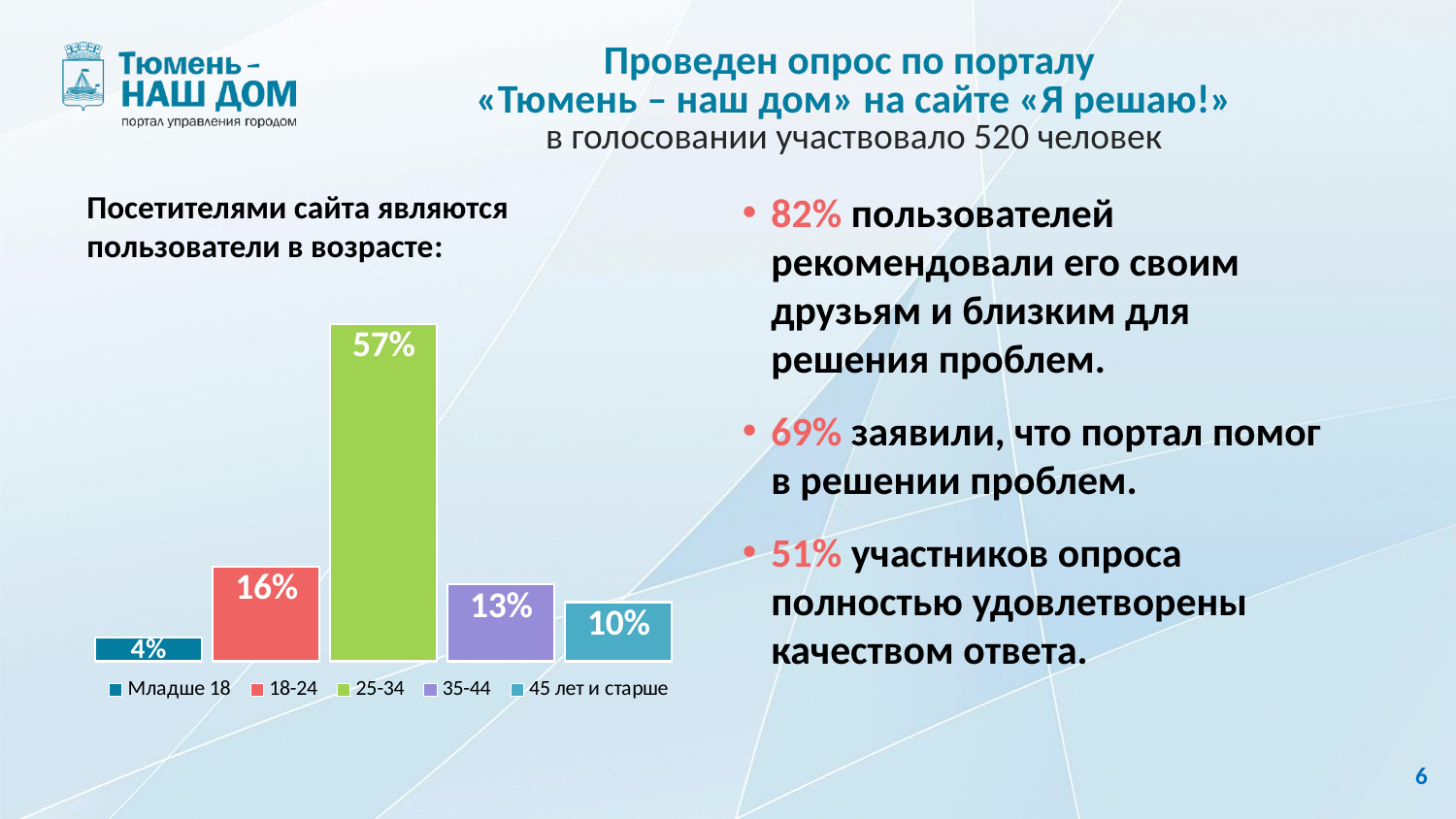
Which age group has the lowest share of site visitors? Младше 18 Which is larger: the share of visitors aged 18-24 or aged 35-44? 18-24 What share of site visitors are younger than 18 (Младше 18)? 4% What is the difference between the share of visitors aged 35-44 and those aged 45 and older? 3% What share of site visitors are aged 45 and older (45 лет и старше)? 10% Which age group has the highest share of site visitors? 25-34 What share of site visitors are aged 25-34? 57% What is the difference between the share of visitors aged 25-34 and those aged 18-24? 41% How many age groups are shown in the chart? 5 How many entries does the chart legend list? 5 What colour is the bar for the 25-34 age group? Green What type of chart is used to show the age distribution of site visitors? Bar chart